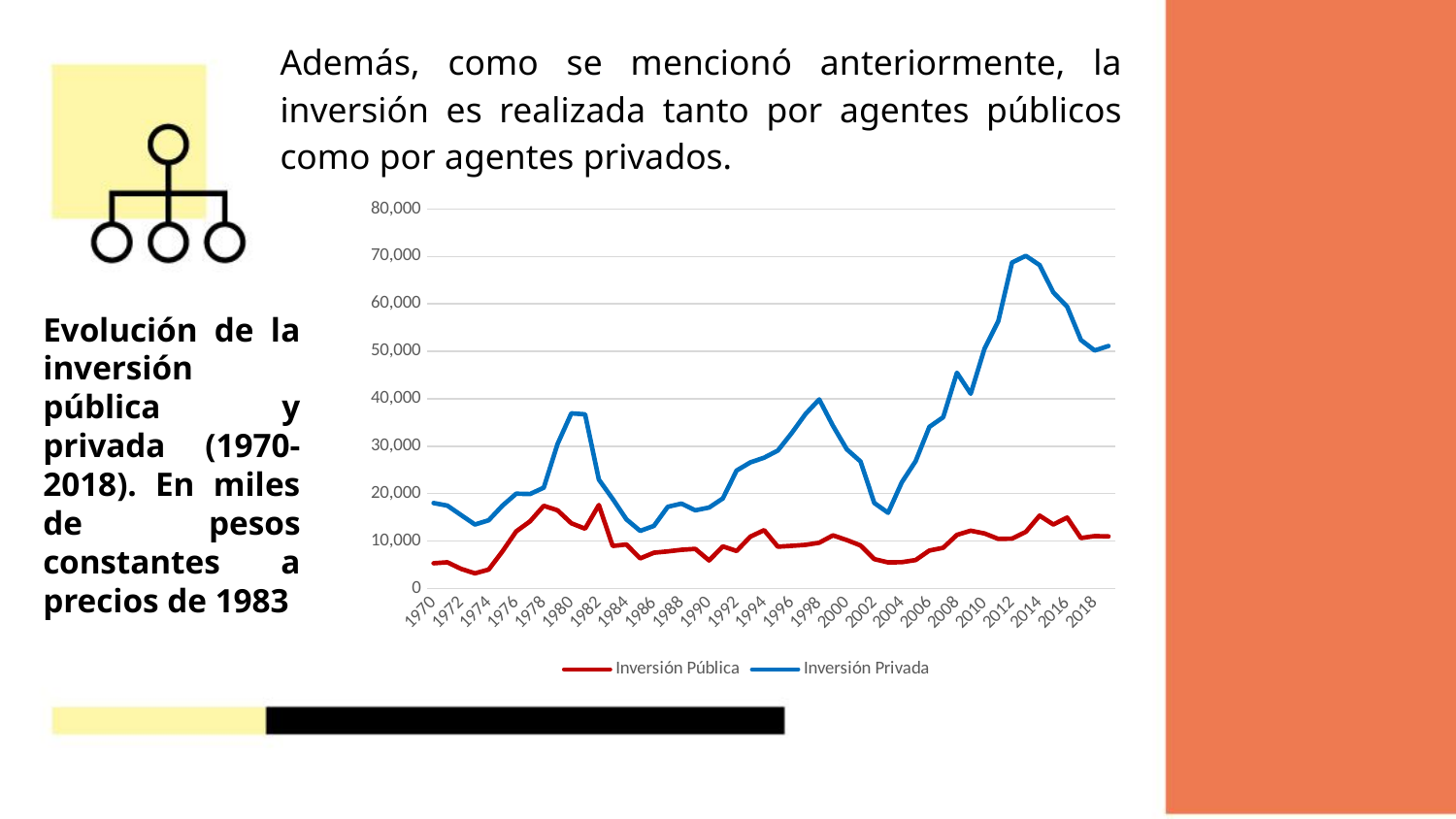
Which series has the higher value in 1990, Inversión Pública or Inversión Privada? Inversión Privada What are the two series named in the legend? Inversión Pública and Inversión Privada Does Inversión Privada rise or fall between 2014 and 2018? Fall How many series does the legend list? 2 What kind of chart is shown on the slide? Line chart Is the value of Inversión Privada in 1986 greater or less than 20,000? less Is the value of Inversión Pública in 2004 greater or less than 10,000? less What colour is the Inversión Pública line? Red Is the value of Inversión Privada in 2013 greater or less than 60,000? greater Which series reaches the highest peak on the chart? Inversión Privada Does Inversión Privada rise or fall between 2004 and 2012? Rise